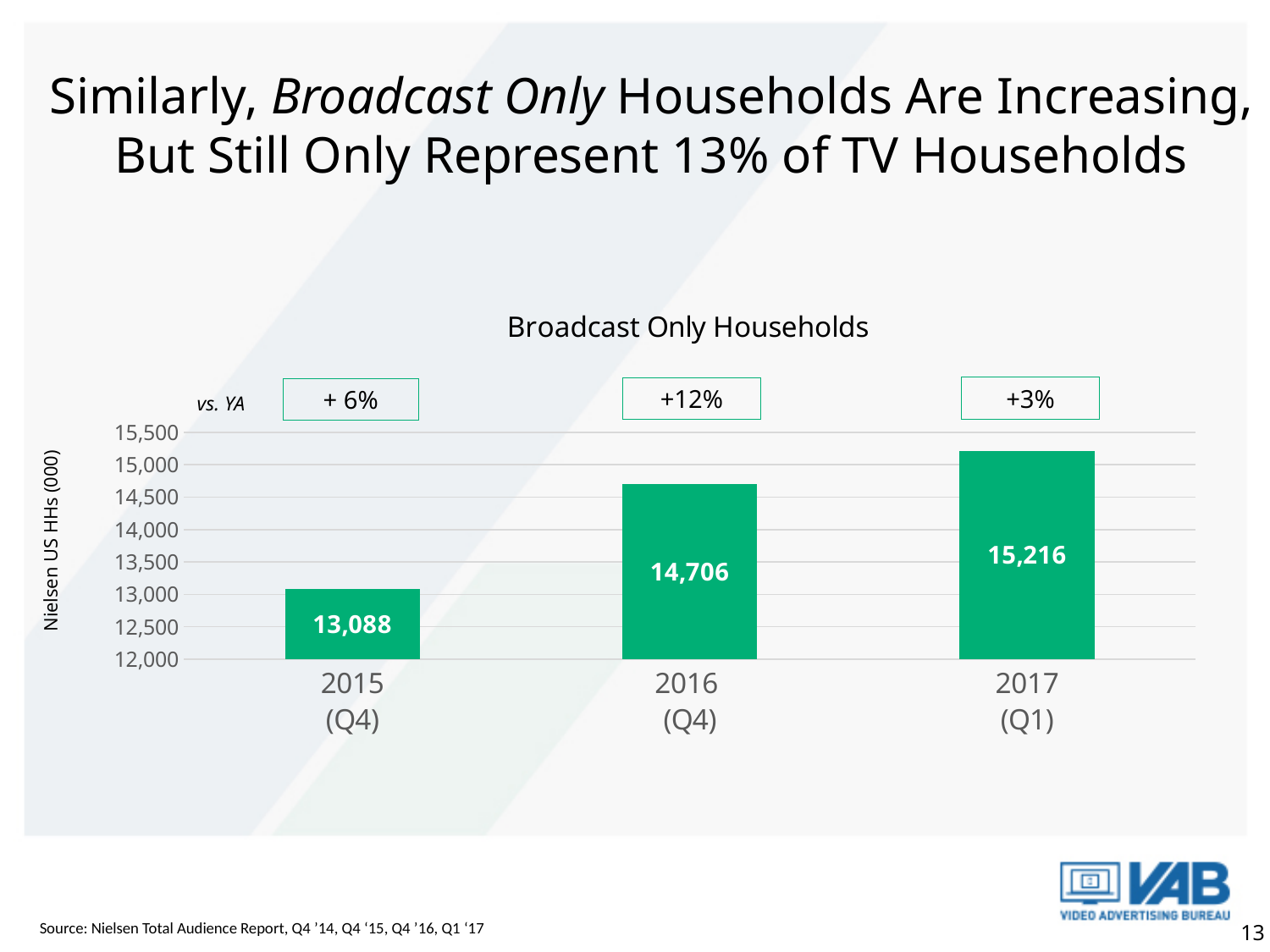
Do the values rise or fall from 2015 (Q4) to 2017 (Q1) in the Broadcast Only Households chart? rise What is the difference between the 2017 (Q1) and 2015 (Q4) values in the Broadcast Only Households chart? 2,128 What is the difference between the 2016 (Q4) and 2015 (Q4) values in the Broadcast Only Households chart? 1,618 What is the value for 2015 (Q4) in the Broadcast Only Households chart? 13,088 Is the value for 2015 (Q4) greater or less than 13,500? less Which period has the lowest value in the Broadcast Only Households chart? 2015 (Q4) What is the value for 2016 (Q4) in the Broadcast Only Households chart? 14,706 What is the value for 2017 (Q1) in the Broadcast Only Households chart? 15,216 Which is larger in the Broadcast Only Households chart, the value for 2016 (Q4) or 2017 (Q1)? 2017 (Q1) What kind of chart is shown on the slide? bar chart Which period has the highest value in the Broadcast Only Households chart? 2017 (Q1) How many periods are shown in the Broadcast Only Households chart? 3